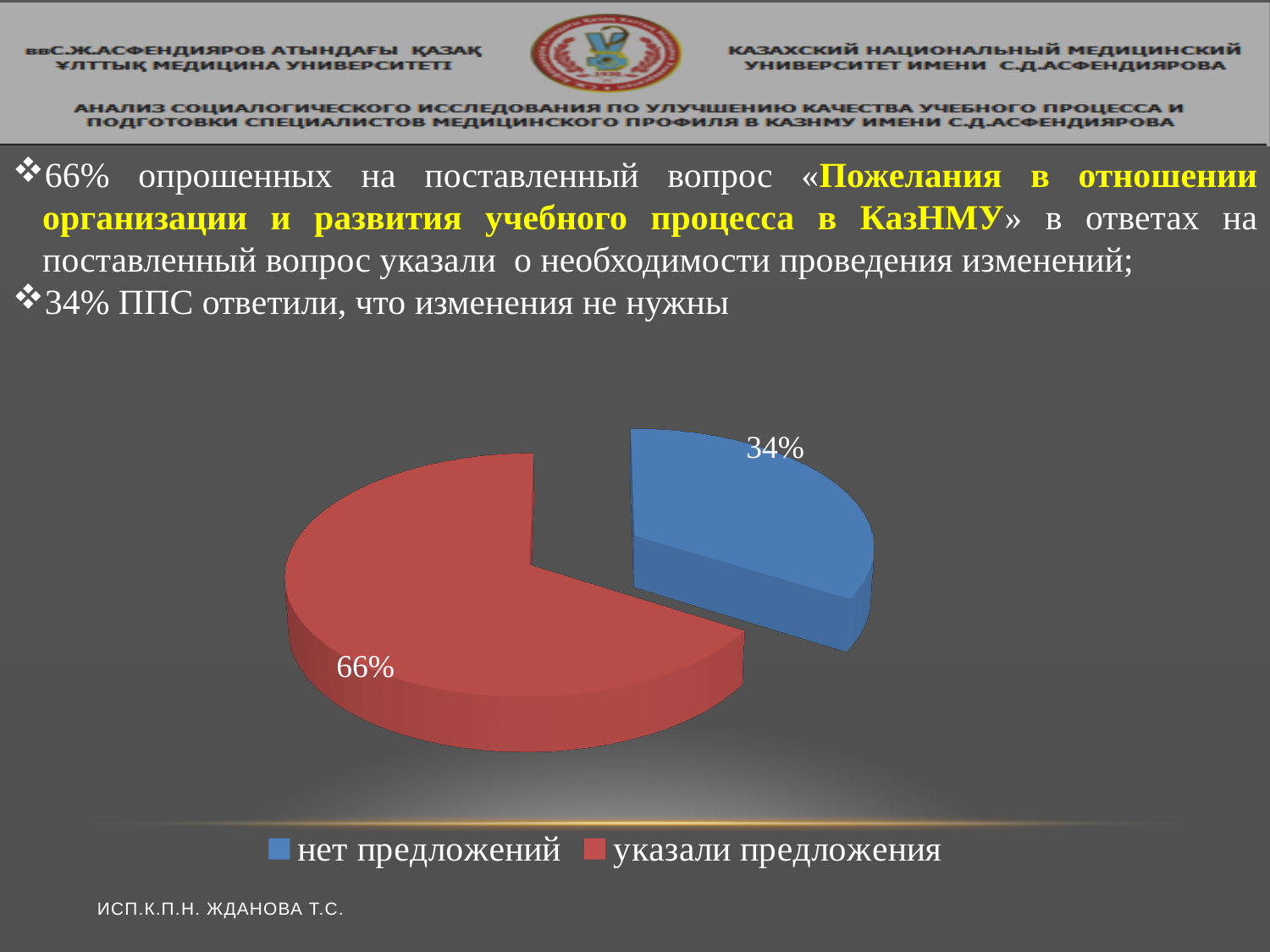
What share of the pie does the "указали предложения" slice represent? 66% What colour is the "указали предложения" slice? red Which category has the largest slice of the pie? указали предложения What colour is the "нет предложений" slice? blue Which is larger: the "нет предложений" slice or the "указали предложения" slice? указали предложения What is the difference in percentage points between the "указали предложения" and "нет предложений" slices? 32% What share of the pie does the "нет предложений" slice represent? 34% Which category has the smallest slice of the pie? нет предложений How many slices does the pie chart have? 2 How many entries does the legend list? 2 What kind of chart is shown on the slide? pie chart Is the value for "нет предложений" greater or less than 50%? less